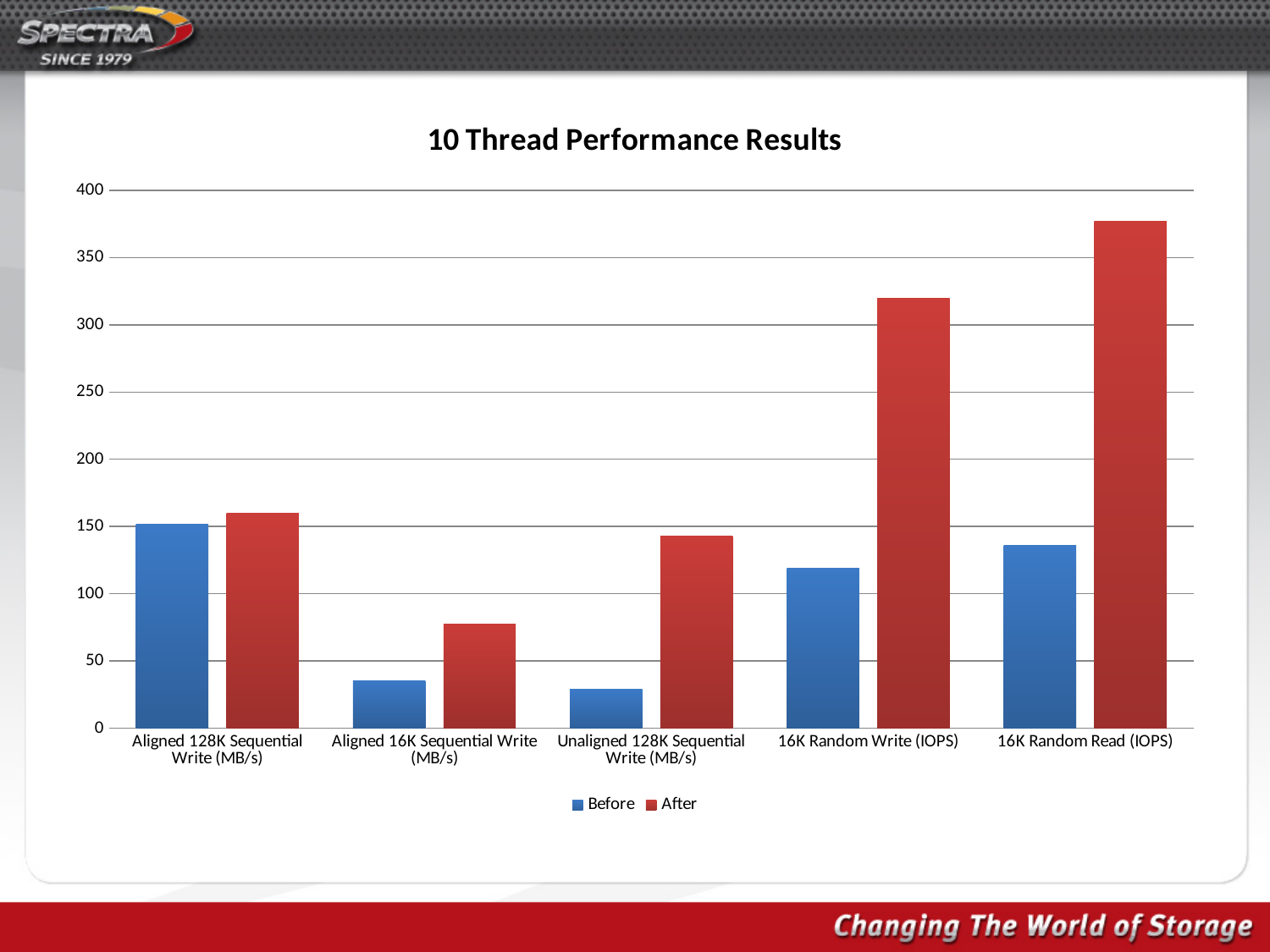
How many categories are shown on the x axis? 5 What is the title of the chart? 10 Thread Performance Results What kind of chart is shown on the slide? bar chart Which category has the highest After value? 16K Random Read (IOPS) Is the After value for 16K Random Read (IOPS) greater or less than 350? greater Is the After value for Unaligned 128K Sequential Write (MB/s) greater or less than 100? greater How many series does the legend list? 2 Which colour represents the After series in the legend? red Is the After value for 16K Random Write (IOPS) greater or less than 300? greater Which category has the highest Before value? Aligned 128K Sequential Write (MB/s) For Unaligned 128K Sequential Write (MB/s), which is larger, the Before value or the After value? After